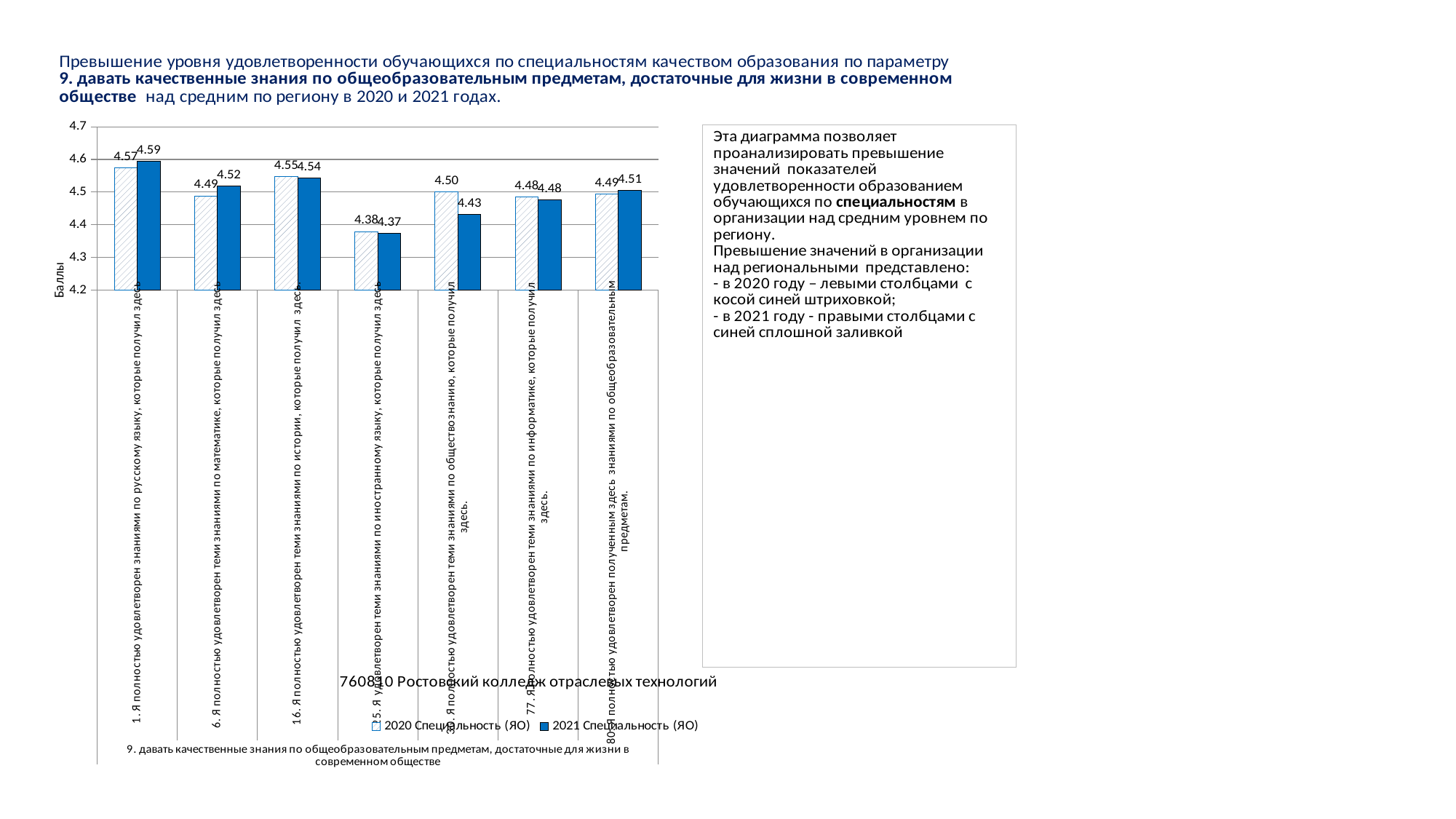
Is the 2020 value for the foreign language category (item 25) greater or less than 4.4? less Which category has the highest 2021 value? 1. Я полностью удовлетворен знаниями по русскому языку, которые получил здесь What is the 2021 value for the category about knowledge of mathematics (item 6)? 4.52 What is the label of the y axis? Баллы What is the 2021 value for the category about knowledge of social studies (item 30, обществознанию)? 4.43 What is the difference between the 2020 and 2021 values for the social studies category (item 30)? 0.07 For the history category (item 16), which is larger: the 2020 value or the 2021 value? 2020 How many categories are shown on the x axis? 7 Which category has the lowest 2020 value? 25. Я удовлетворен теми знаниями по иностранному языку, которые получил здесь How many series does the legend list? 2 What is the 2020 value for the category about knowledge of Russian language (item 1)? 4.57 What kind of chart is shown on the slide? bar chart